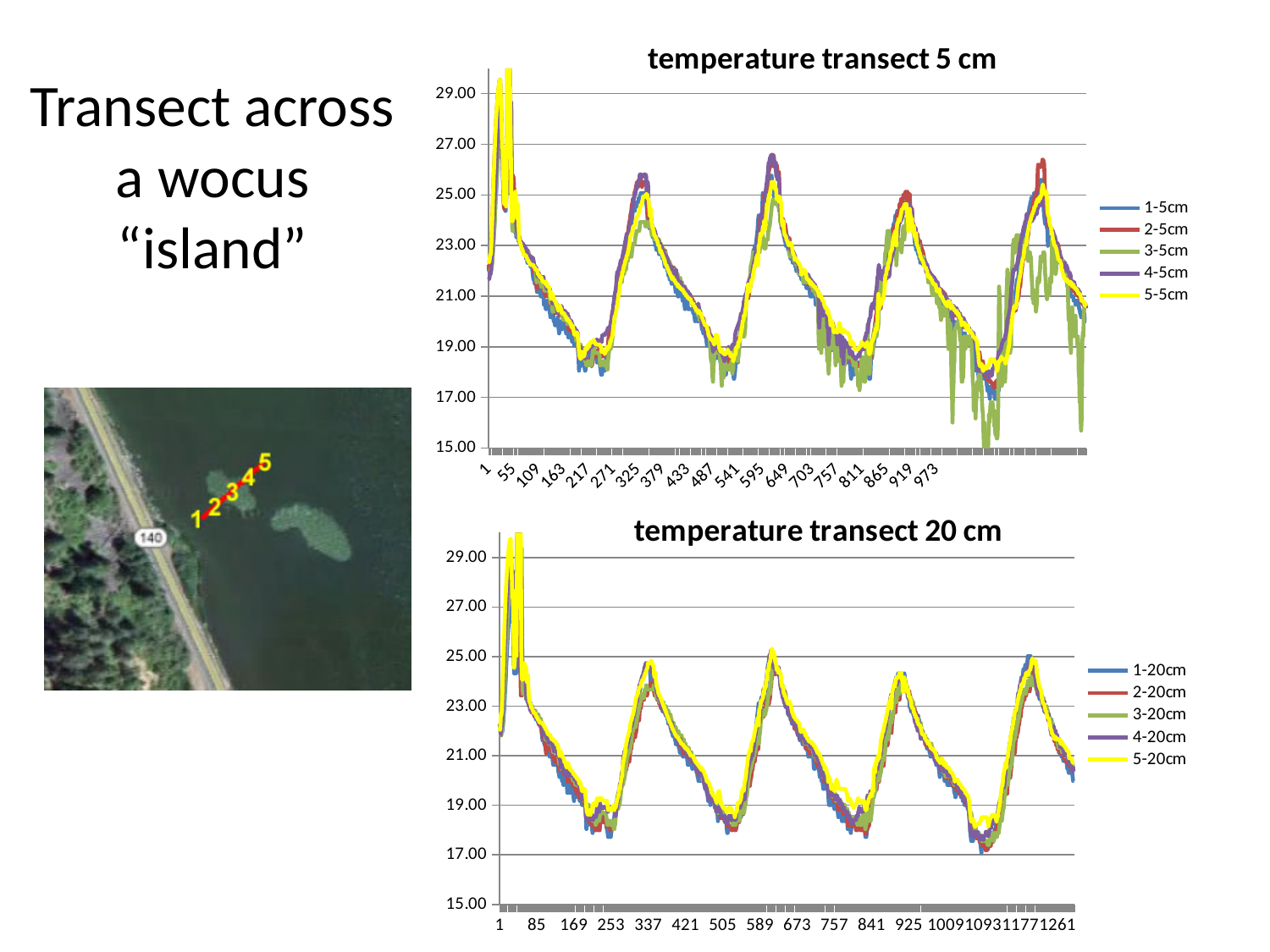
How many series does the legend of the "temperature transect 5 cm" chart list? 5 What kind of chart is the "temperature transect 20 cm" chart? line chart In the "temperature transect 5 cm" chart, is the value of the yellow 5-5cm series at x = 1 greater or less than 25.00? less In the "temperature transect 20 cm" chart, is the highest value reached by the yellow 5-20cm series near the start greater or less than 27.00? greater In the "temperature transect 20 cm" chart, which series is drawn in blue? 1-20cm In the "temperature transect 5 cm" chart, which series is drawn in yellow? 5-5cm What is the lowest value shown on the y axis of the "temperature transect 20 cm" chart? 15.00 In the "temperature transect 5 cm" chart, is the highest value reached by the yellow 5-5cm series near the start greater or less than 27.00? greater How many series does the legend of the "temperature transect 20 cm" chart list? 5 What kind of chart is the "temperature transect 5 cm" chart? line chart